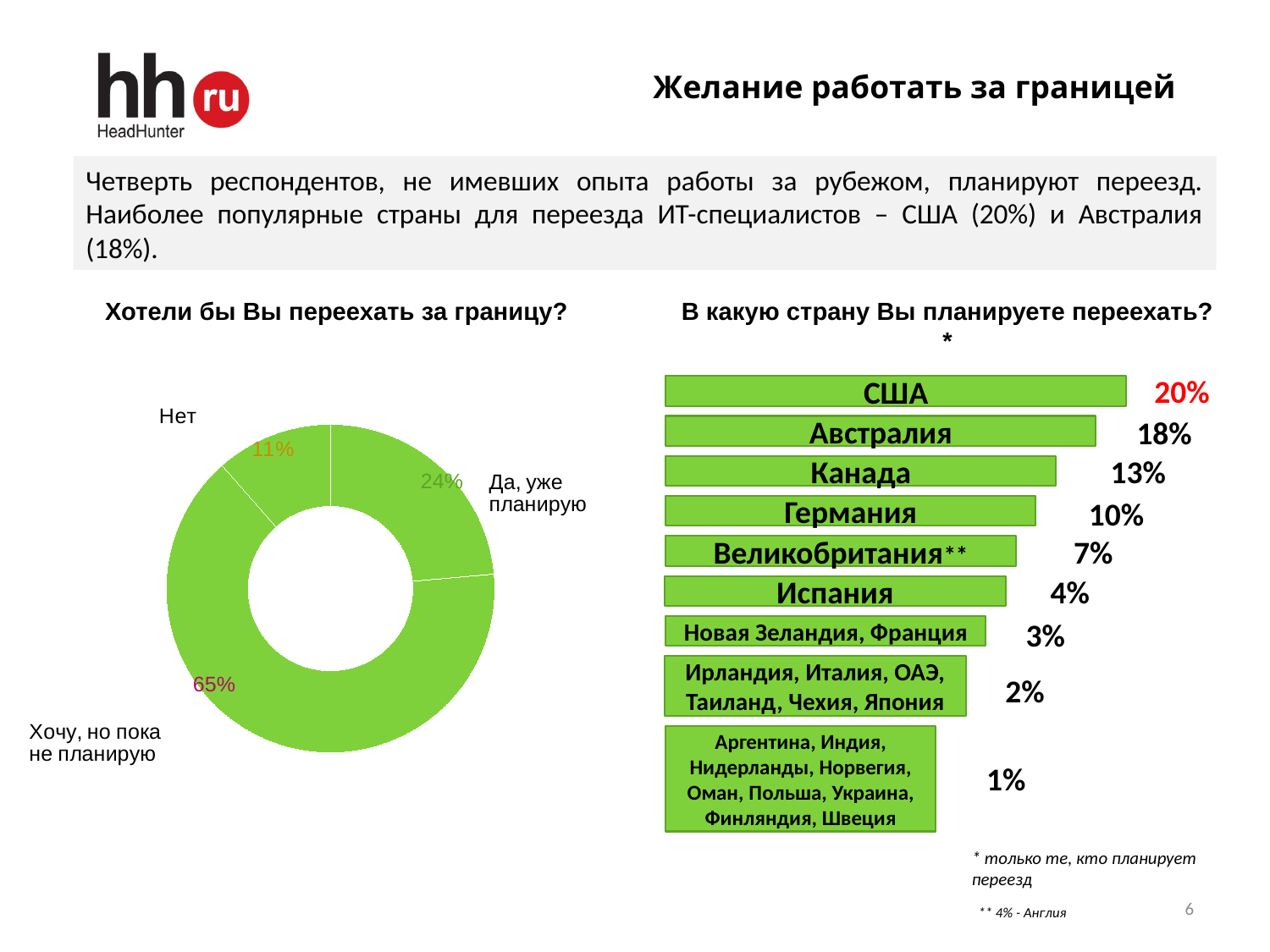
In the chart 'В какую страну Вы планируете переехать?', what is the value for Канада? 13% What kind of chart is 'В какую страну Вы планируете переехать?'? Bar chart In the chart 'В какую страну Вы планируете переехать?', which country has the highest value? США In the chart 'Хотели бы Вы переехать за границу?', which answer has the largest share? Хочу, но пока не планирую What kind of chart is 'Хотели бы Вы переехать за границу?'? Donut (pie) chart In the chart 'В какую страну Вы планируете переехать?', what is the difference between the values for США and Австралия? 2% How many bars are shown in the chart 'В какую страну Вы планируете переехать?'? 9 In the chart 'Хотели бы Вы переехать за границу?', what share of respondents answered 'Хочу, но пока не планирую'? 65% In the chart 'Хотели бы Вы переехать за границу?', what share of respondents answered 'Да, уже планирую'? 24% In the chart 'В какую страну Вы планируете переехать?', what is the value for Великобритания? 7% In the chart 'В какую страну Вы планируете переехать?', which has a larger value, Германия or Испания? Германия In the chart 'Хотели бы Вы переехать за границу?', what share of respondents answered 'Нет'? 11%